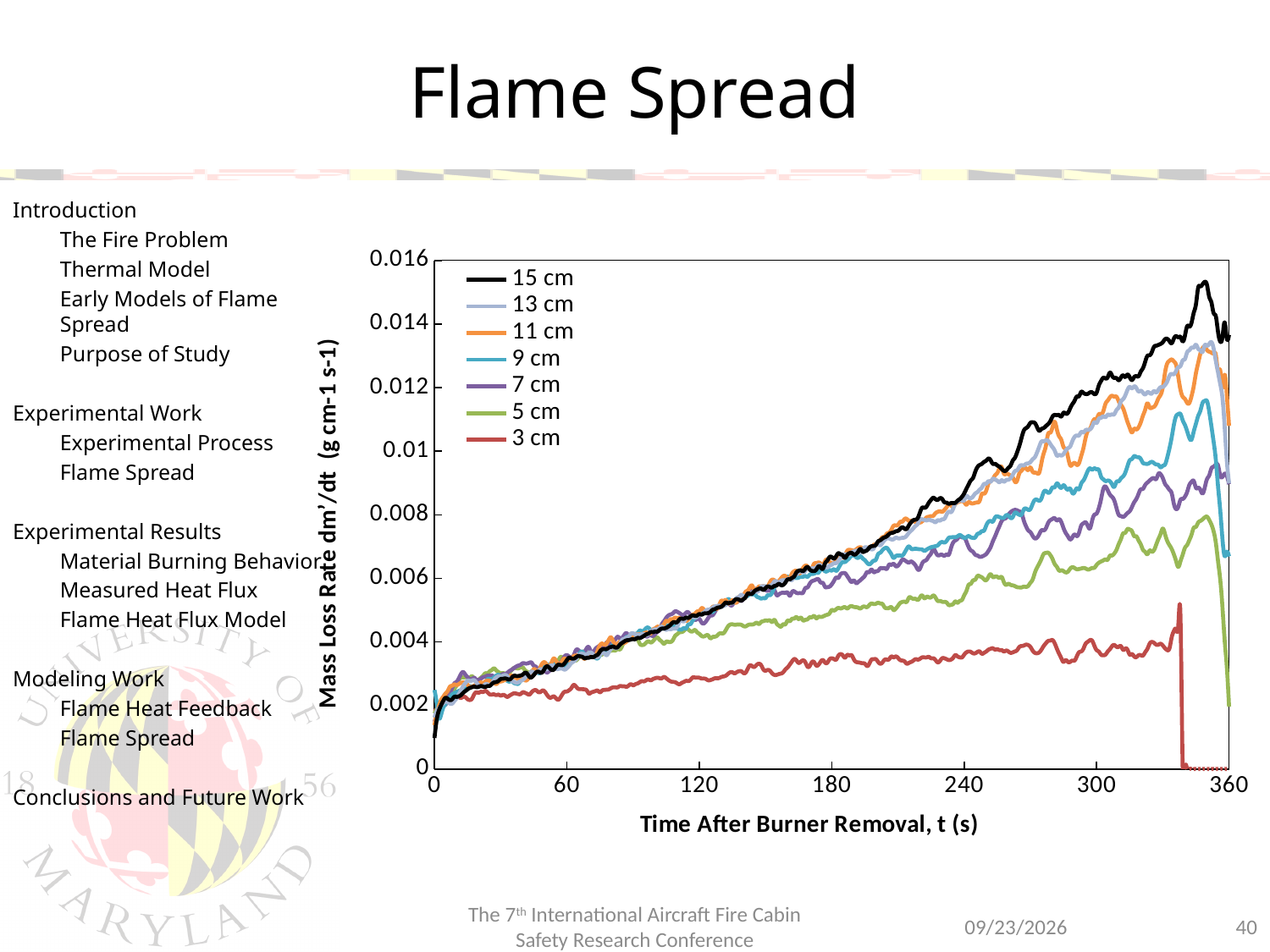
How many series does the chart legend list? 7 Which series has the lowest mass loss rate across the chart? 3 cm Which series reaches the highest mass loss rate on the chart? 15 cm Is the value for the 9 cm series at 180 s greater or less than 0.004? greater Is the value for the 5 cm series at 240 s greater or less than 0.008? less At 120 s, which series has the larger mass loss rate, 3 cm or 15 cm? 15 cm Is the peak value of the 15 cm series greater or less than 0.014? greater What kind of chart is shown on the slide? line chart Does the mass loss rate for the 15 cm series rise or fall between 0 s and 300 s? rises At 300 s, which series has the larger mass loss rate, 7 cm or 5 cm? 7 cm What is the title of the x axis of the chart? Time After Burner Removal, t (s)